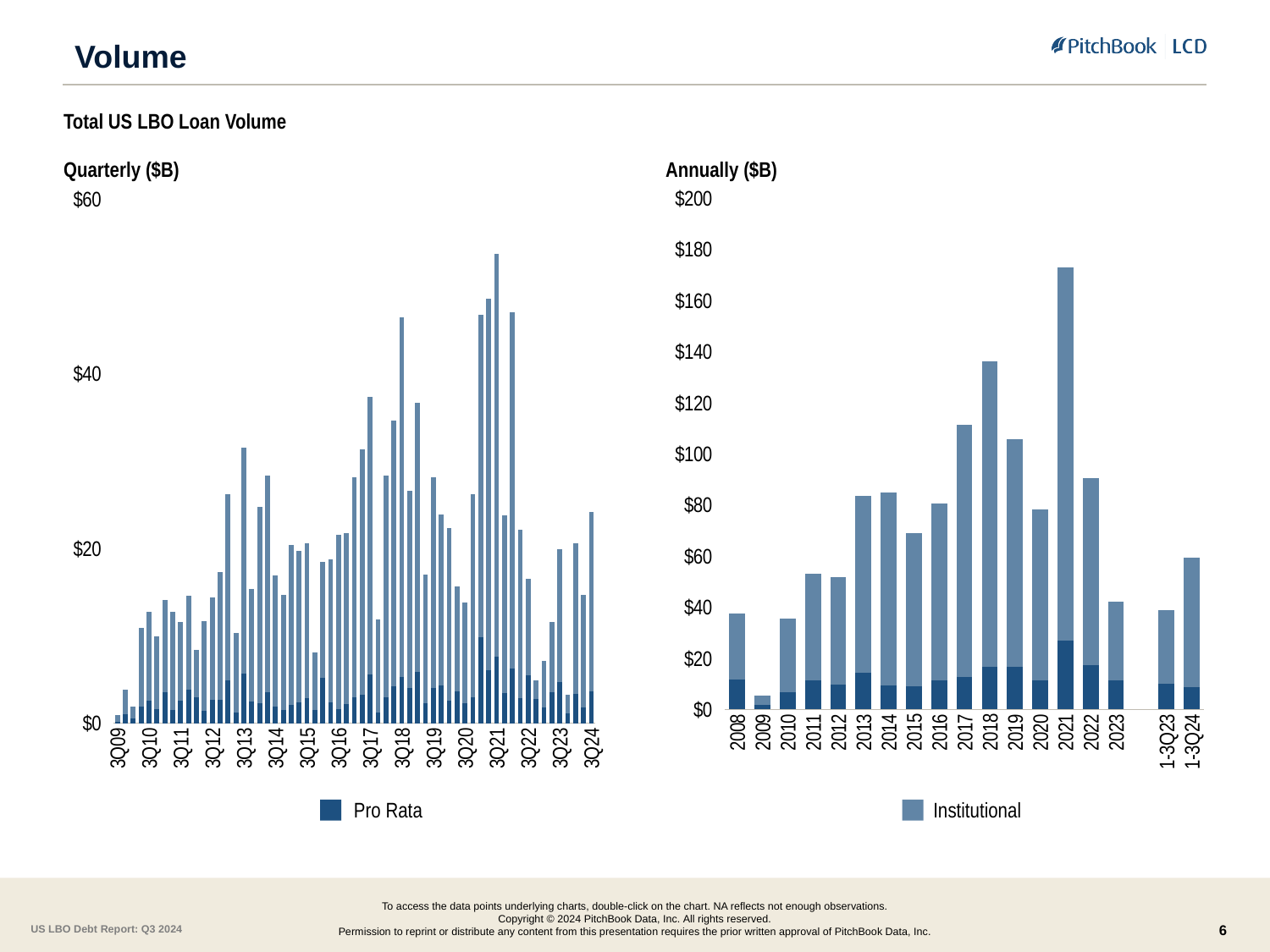
Which legend entry is shown in the darker blue colour? Pro Rata In the Annually ($B) chart, is the total for 2021 greater or less than $160? greater What kind of chart is the Annually ($B) chart? stacked bar chart In the Annually ($B) chart, which is larger, the total for 1-3Q23 or the total for 1-3Q24? 1-3Q24 In the Annually ($B) chart, do the totals rise or fall from 2021 to 2023? fall In the Annually ($B) chart, which year has the highest total LBO loan volume? 2021 In the Annually ($B) chart, is the total for 2009 greater or less than $20? less In the Annually ($B) chart, which year has the lowest total LBO loan volume? 2009 In the Annually ($B) chart, is the total for 2018 greater or less than $120? greater How many series does the legend list for the charts? 2 In the Annually ($B) chart, which is larger, the total for 2019 or the total for 2020? 2019